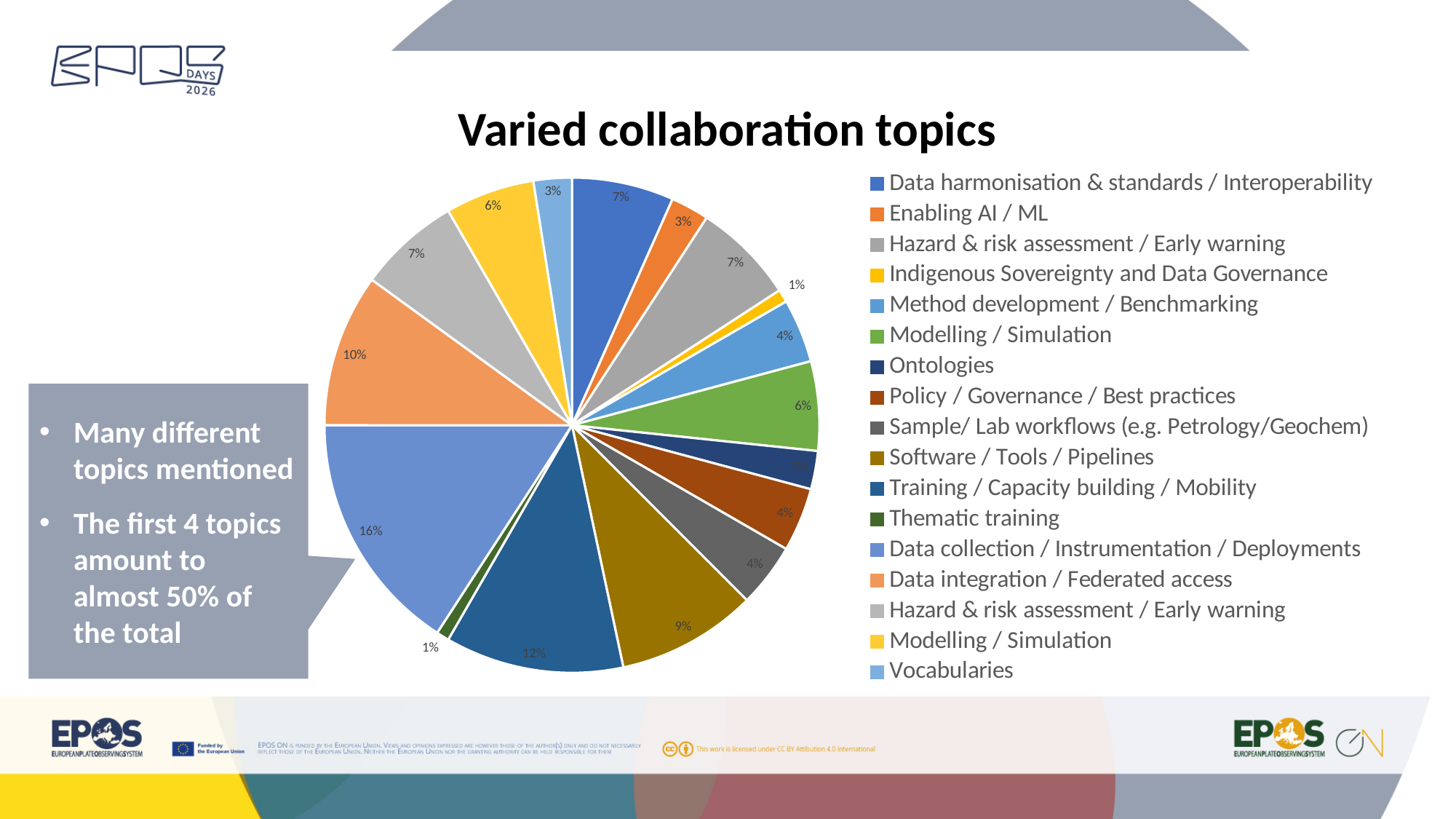
What is the value shown for Data harmonisation & standards / Interoperability? 7% How many entries does the legend list? 17 What type of chart is shown on the slide? pie chart What is the title of the chart? Varied collaboration topics What is the value shown for Method development / Benchmarking? 4% Which category has the largest share of the pie? Data collection / Instrumentation / Deployments Which is larger: Training / Capacity building / Mobility or Software / Tools / Pipelines? Training / Capacity building / Mobility What is the difference between the shares of Data collection / Instrumentation / Deployments and Data integration / Federated access? 6 percentage points What is the value shown for Software / Tools / Pipelines? 9% What is the value shown for Data integration / Federated access? 10% What is the value shown for Enabling AI / ML? 3% What share of the pie does Training / Capacity building / Mobility have? 12%